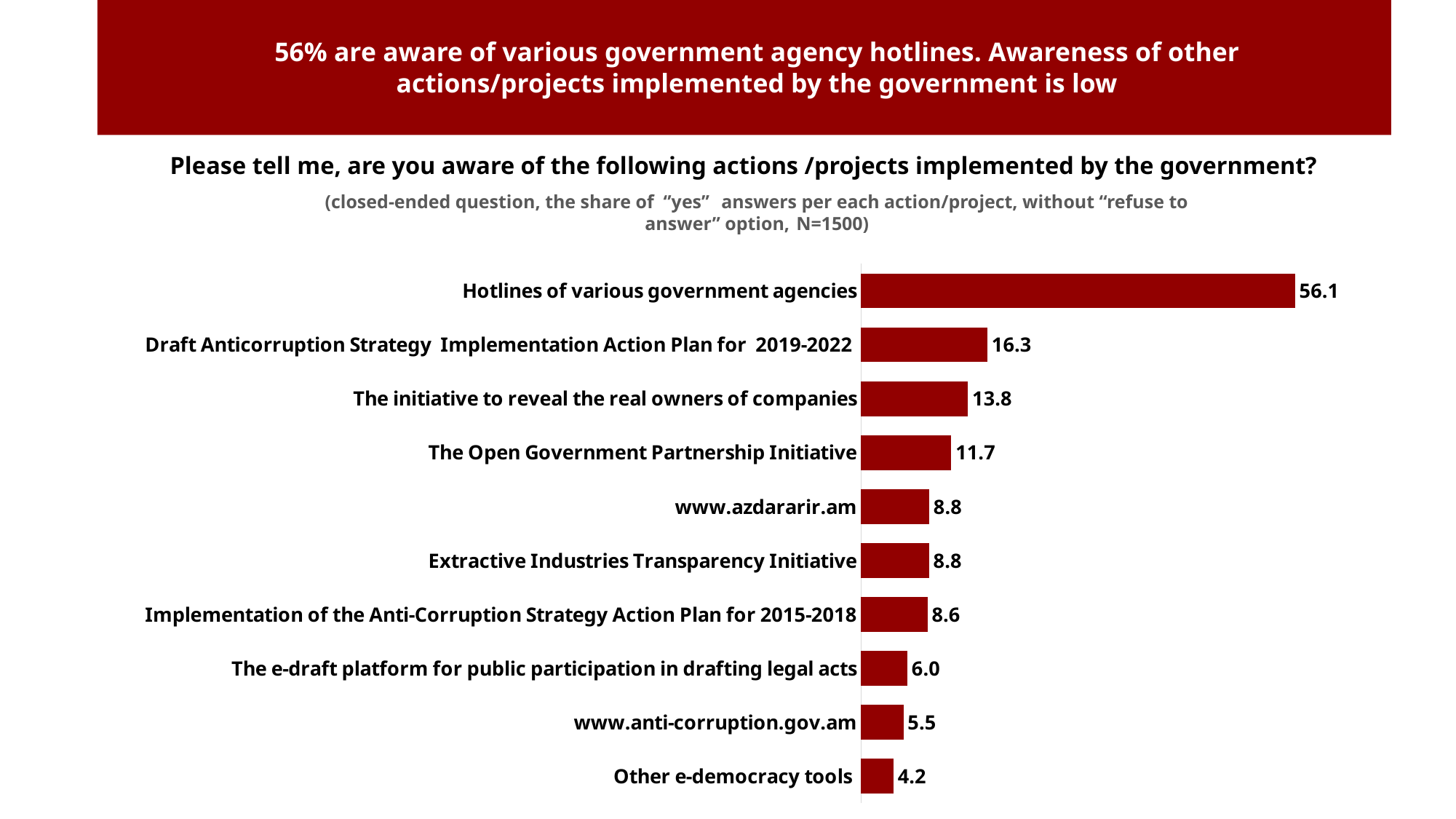
What kind of chart is shown on the slide? Bar chart Which is larger, the value for Draft Anticorruption Strategy Implementation Action Plan for 2019-2022 or the value for Implementation of the Anti-Corruption Strategy Action Plan for 2015-2018? Draft Anticorruption Strategy Implementation Action Plan for 2019-2022 What is the value for www.anti-corruption.gov.am? 5.5 What is the sample size (N) stated in the chart subtitle? N=1500 What is the value for The e-draft platform for public participation in drafting legal acts? 6.0 What is the difference between the values for The initiative to reveal the real owners of companies and The Open Government Partnership Initiative? 2.1 What is the value for Hotlines of various government agencies? 56.1 Which category has the highest value? Hotlines of various government agencies What is the value for The Open Government Partnership Initiative? 11.7 How many categories are shown in the chart? 10 Which category has the lowest value? Other e-democracy tools What is the difference between the values for Hotlines of various government agencies and Draft Anticorruption Strategy Implementation Action Plan for 2019-2022? 39.8